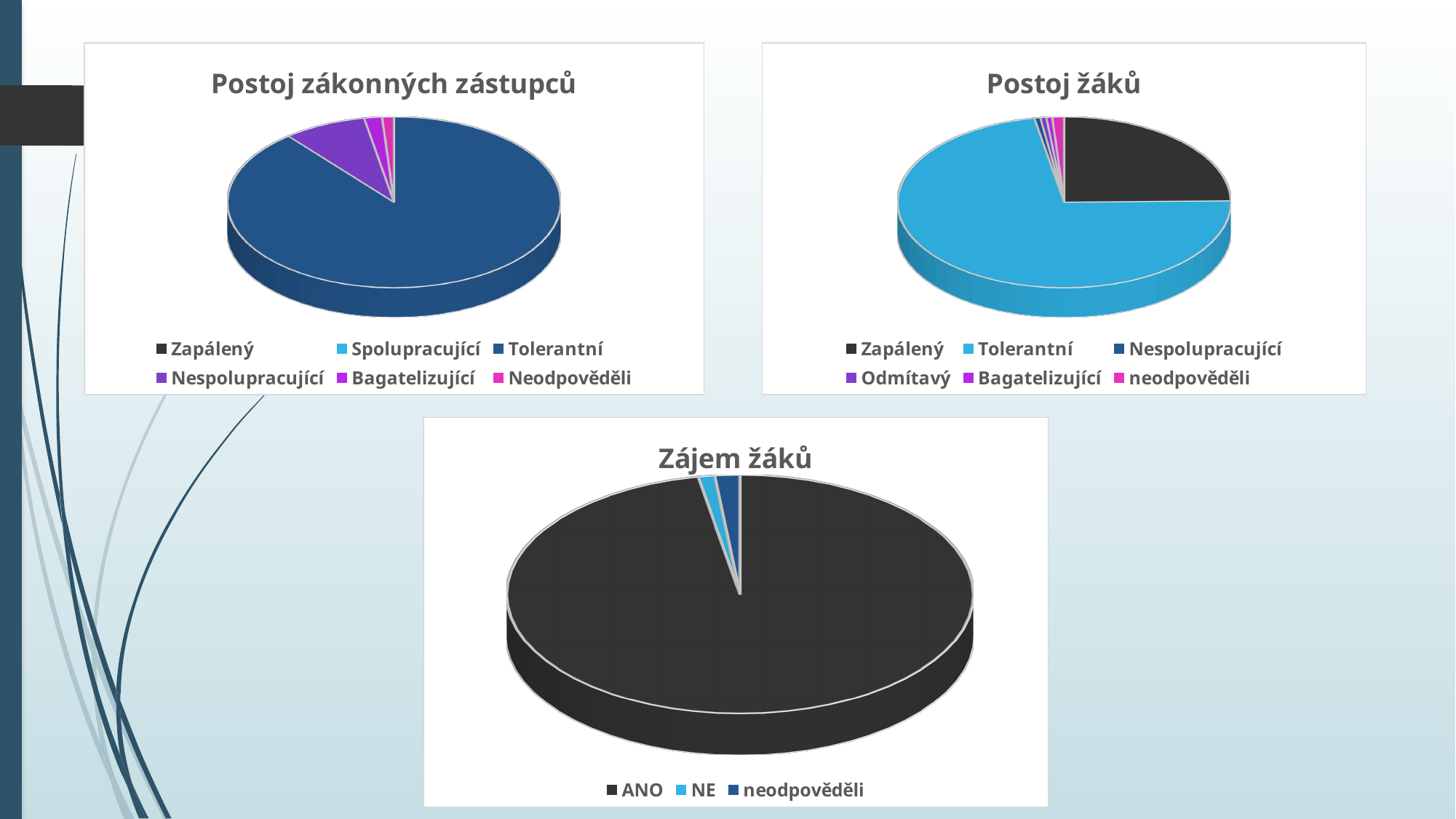
How many categories does the legend of the "Zájem žáků" chart list? 3 In the "Postoj zákonných zástupců" chart, which slice is larger: Nespolupracující or Bagatelizující? Nespolupracující In the "Postoj zákonných zástupců" chart, which category has the largest slice? Tolerantní What kind of chart is "Zájem žáků"? pie chart What kind of chart is "Postoj zákonných zástupců"? pie chart How many categories does the legend of the "Postoj žáků" chart list? 6 In the "Zájem žáků" chart, which colour represents ANO? dark grey What is the title of the chart at the bottom of the slide? Zájem žáků How many categories does the legend of the "Postoj zákonných zástupců" chart list? 6 In the "Postoj žáků" chart, which slice is larger: Zapálený or Tolerantní? Tolerantní In the "Postoj žáků" chart, which category has the largest slice? Tolerantní In the "Zájem žáků" chart, which category has the largest slice? ANO